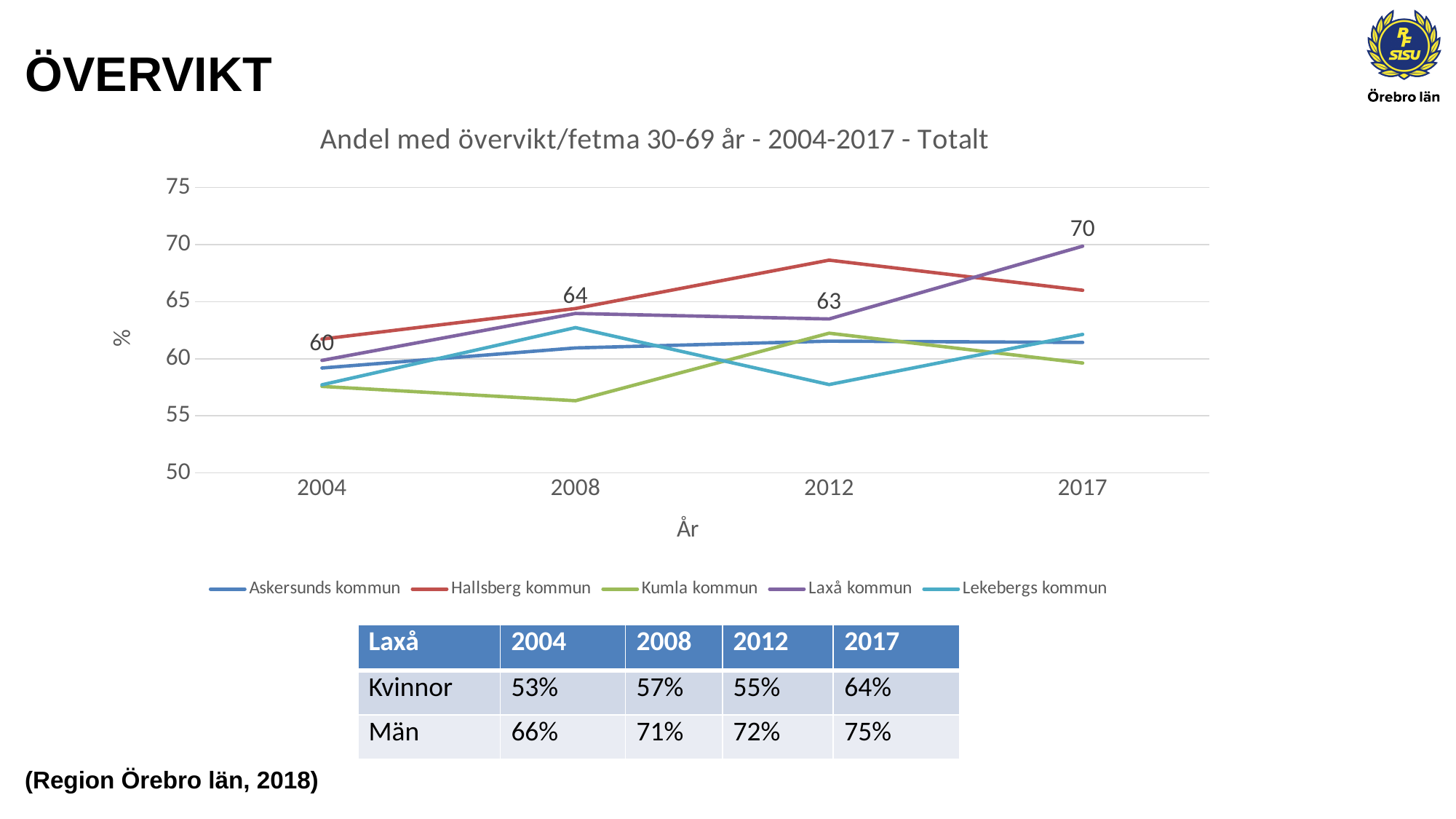
In 2012, which is larger: the value for Hallsberg kommun or Askersunds kommun? Hallsberg kommun What type of chart is shown on the slide? line chart How many series does the chart legend list? 5 How many years are plotted along the x axis of the chart? 4 What is the value for Laxå kommun in 2017? 70 What is the value for Laxå kommun in 2004? 60 Is the value for Hallsberg kommun in 2012 greater or less than 65? greater By how much did the value for Laxå kommun increase from 2004 to 2017? 10 What is the title of the chart? Andel med övervikt/fetma 30-69 år - 2004-2017 - Totalt Which municipality has the lowest value in 2008? Kumla kommun Which municipality has the highest value in 2017? Laxå kommun What is the value for Laxå kommun in 2012? 63